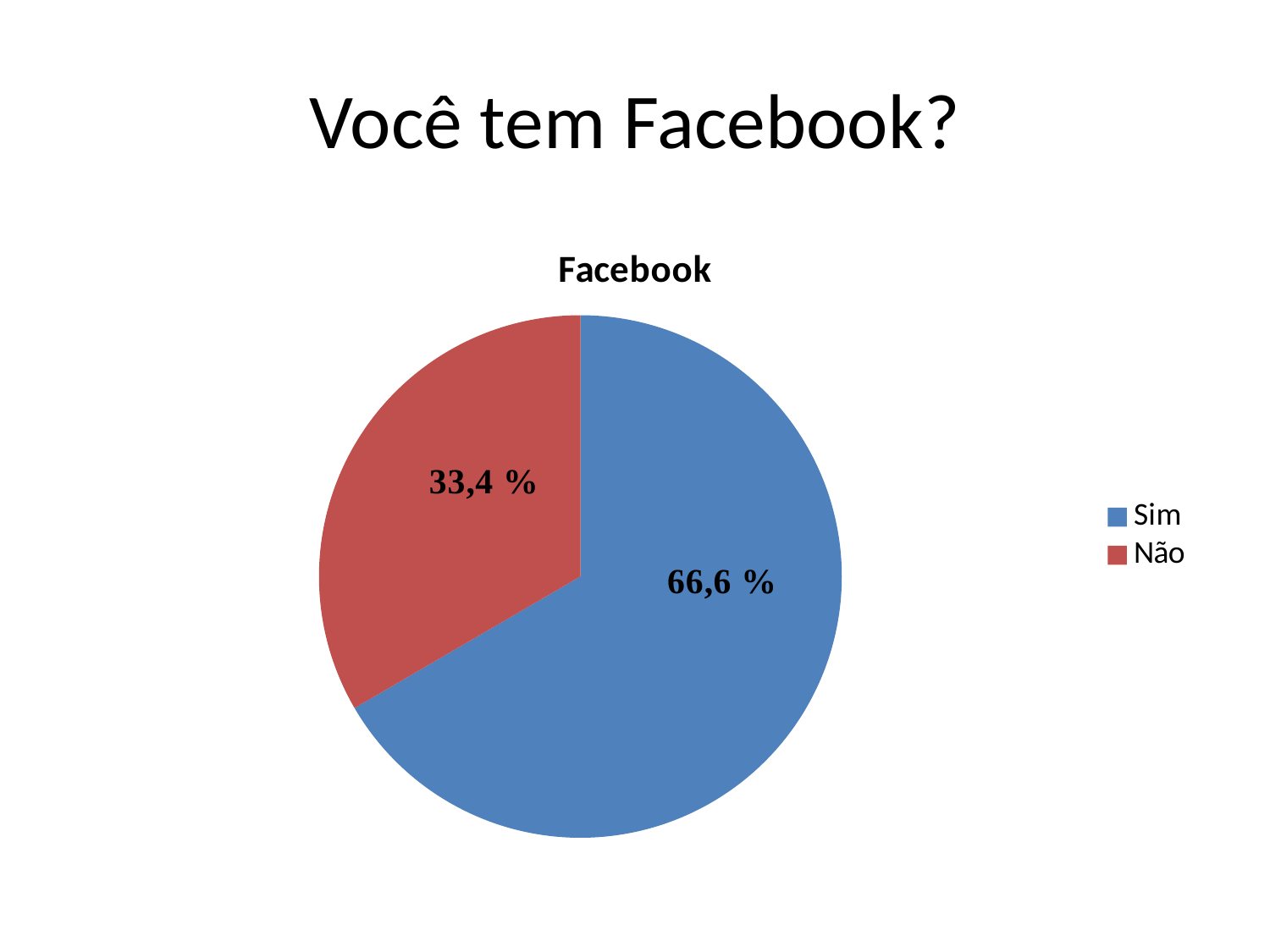
Which category has the largest slice of the pie? Sim What is the difference in percentage points between the Sim and Não slices? 33,2 What type of chart is shown on the slide? pie chart How many slices does the pie chart have? 2 Which is larger, the Sim slice or the Não slice? Sim What share of the pie does the Sim slice represent? 66,6 % Which category has the smallest slice of the pie? Não How many categories does the legend list? 2 What is the title of the chart? Facebook What colour is the Não slice? red What share of the pie does the Não slice represent? 33,4 %